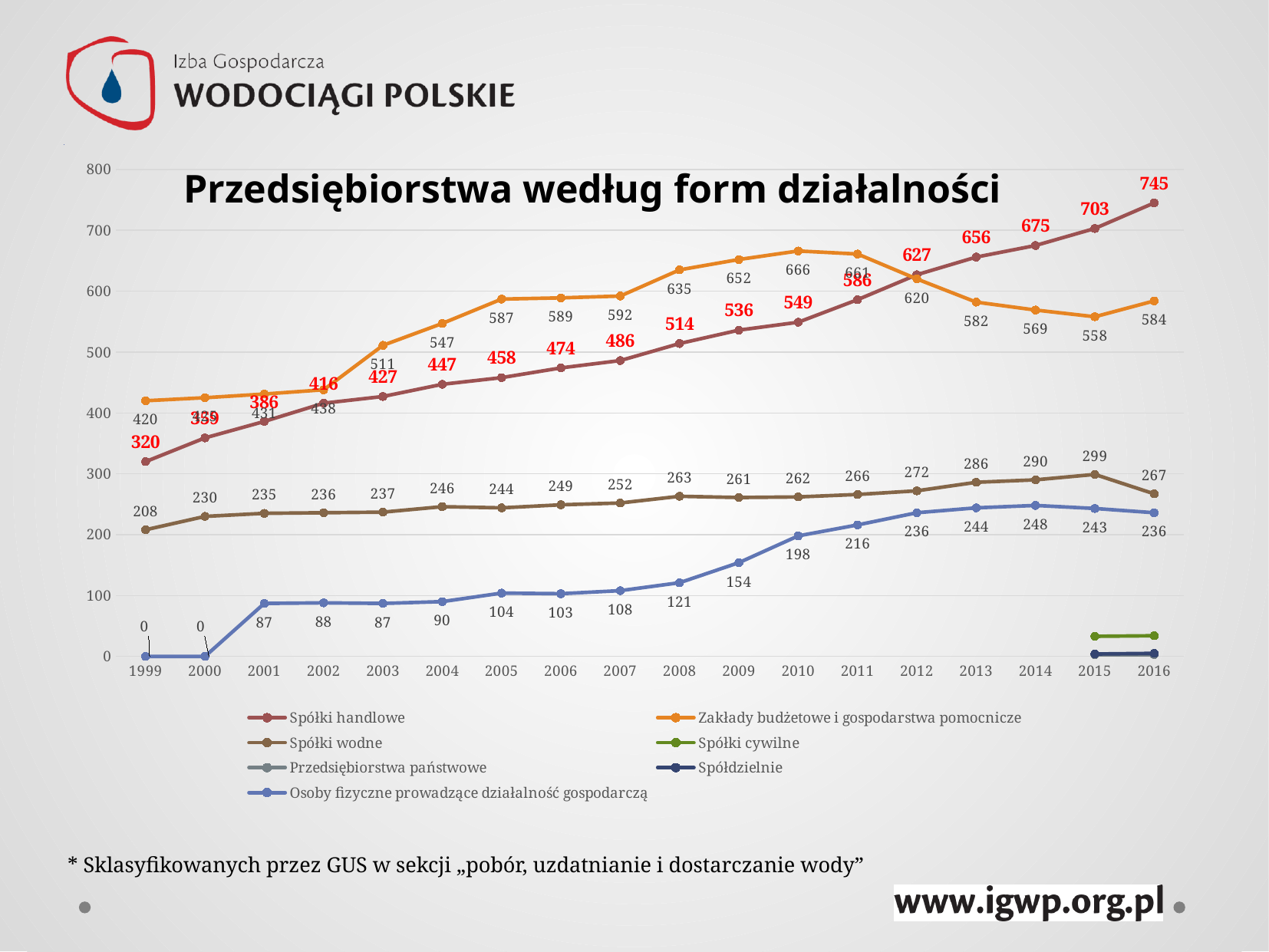
Is the value for Spółki cywilne in 2016 greater or less than 100? less How many years are shown on the x axis? 18 In 2012, which series has the larger value: Spółki handlowe or Zakłady budżetowe i gospodarstwa pomocnicze? Spółki handlowe What is the value for Spółki wodne in 2015? 299 By how much did the value for Spółki handlowe increase from 2015 to 2016? 42 In which year does the Zakłady budżetowe i gospodarstwa pomocnicze series reach its highest value? 2010 What is the value for Spółki handlowe in 2016? 745 What kind of chart is shown on the slide? line chart What is the value for Zakłady budżetowe i gospodarstwa pomocnicze in 2010? 666 How many series does the legend list? 7 In which year is the value for Osoby fizyczne prowadzące działalność gospodarczą the highest? 2014 What is the value for Osoby fizyczne prowadzące działalność gospodarczą in 2009? 154